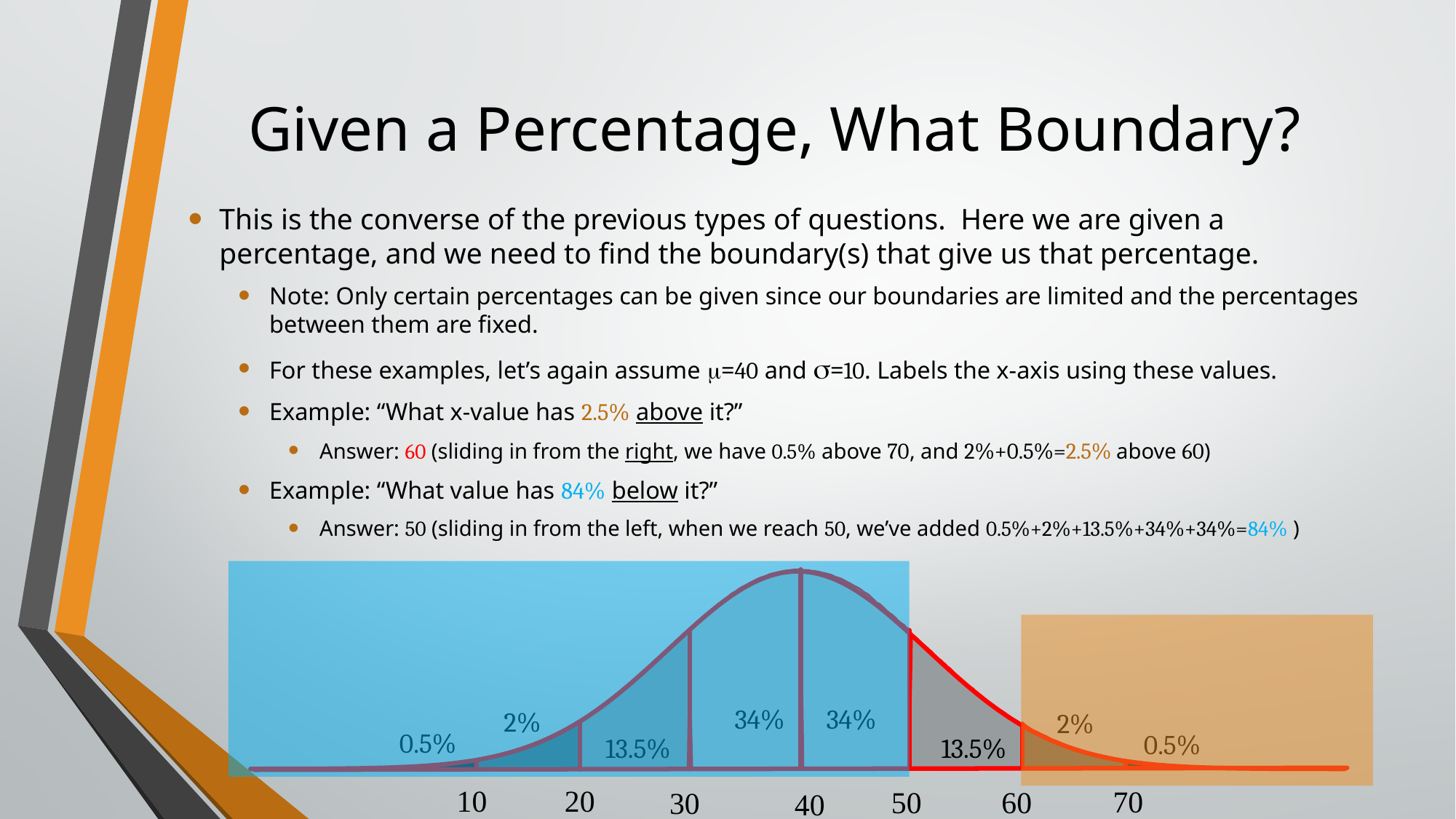
What percentage is labeled for the region between 10 and 20 on the curve? 2% What is the difference between the percentage for the region between 40 and 50 and the percentage for the region between 50 and 60? 20.5% What percentage is labeled for the region between 30 and 40 on the curve? 34% Which labeled region of the curve has the smallest percentage? 0.5% (below 10 and above 70) What x-axis value is at the center (peak) of the curve? 40 Which is larger: the percentage for the region between 20 and 30 or the region between 60 and 70? The region between 20 and 30 (13.5%) What is the total of the percentages labeled for the regions from the left edge up to 50? 84% What percentage is labeled for the region to the right of 70 on the curve? 0.5% How many x-axis tick labels are shown beneath the curve? 7 What is the total of the percentages labeled for the regions between 50 and 60, between 60 and 70, and above 70? 16% Which labeled region of the curve has the largest percentage? 34% (between 30 and 40, and between 40 and 50) What percentage is labeled for the region between 50 and 60 on the curve? 13.5%